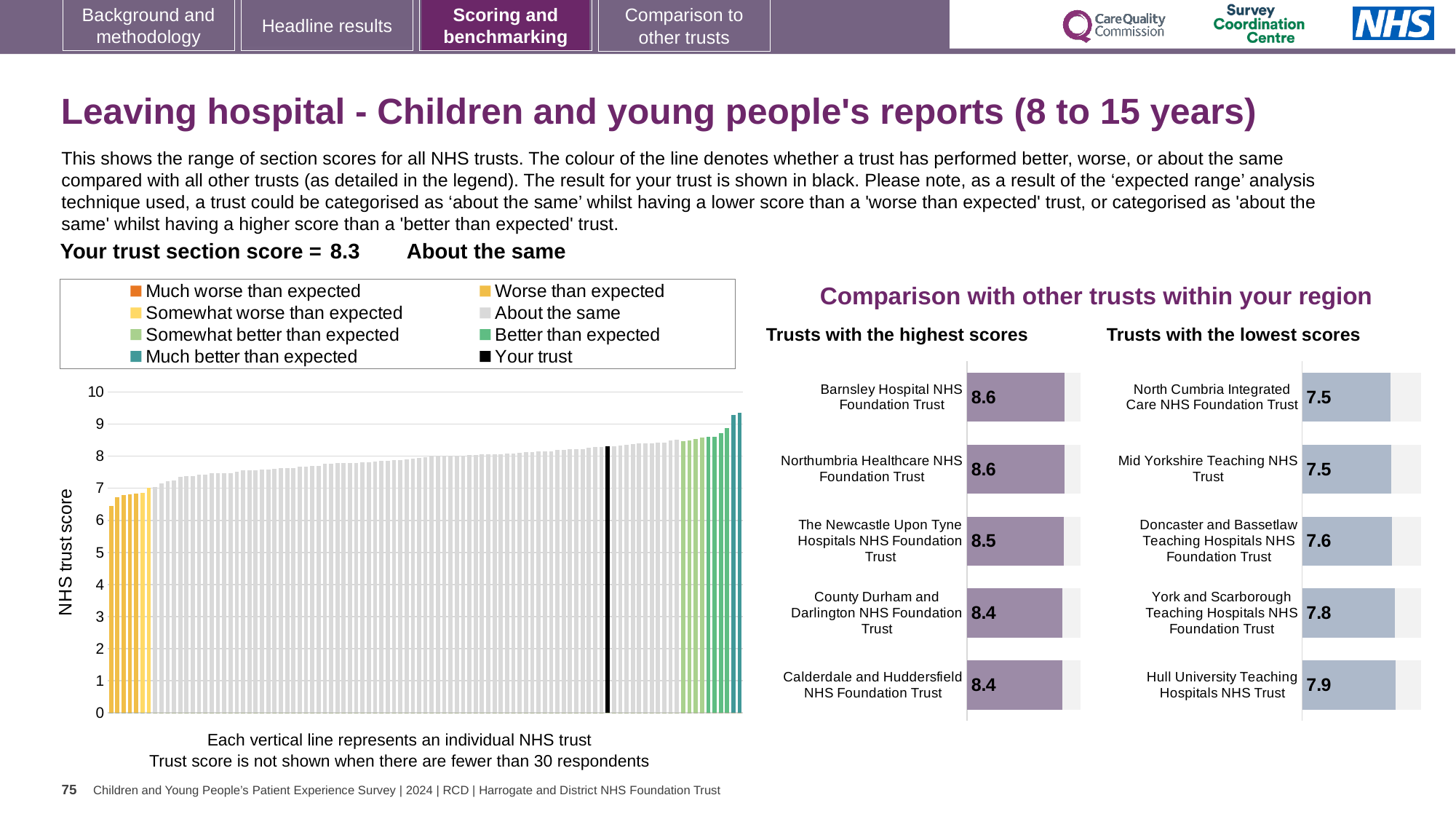
In the 'Trusts with the lowest scores' chart, what is the score for Doncaster and Bassetlaw Teaching Hospitals NHS Foundation Trust? 7.6 In the 'Trusts with the highest scores' chart, what is the score for Barnsley Hospital NHS Foundation Trust? 8.6 How many entries does the legend of the NHS trust score chart on the left list? 8 In the NHS trust score chart on the left, is the value for the black 'Your trust' bar greater or less than 8? greater In the NHS trust score chart on the left, do the values rise or fall from left to right along the x axis? rise In the 'Trusts with the lowest scores' chart, what is the difference between the score for Hull University Teaching Hospitals NHS Trust and the score for North Cumbria Integrated Care NHS Foundation Trust? 0.4 In the 'Trusts with the highest scores' chart, what is the difference between the score for Barnsley Hospital NHS Foundation Trust and the score for Calderdale and Huddersfield NHS Foundation Trust? 0.2 In the 'Trusts with the lowest scores' chart, what is the score for Hull University Teaching Hospitals NHS Trust? 7.9 In the 'Trusts with the highest scores' chart, what is the score for The Newcastle Upon Tyne Hospitals NHS Foundation Trust? 8.5 In the 'Trusts with the lowest scores' chart, which trust has the highest score? Hull University Teaching Hospitals NHS Trust Which is larger: the score for The Newcastle Upon Tyne Hospitals NHS Foundation Trust in the 'Trusts with the highest scores' chart, or the score for Doncaster and Bassetlaw Teaching Hospitals NHS Foundation Trust in the 'Trusts with the lowest scores' chart? The Newcastle Upon Tyne Hospitals NHS Foundation Trust How many trusts are listed in the 'Trusts with the highest scores' chart? 5